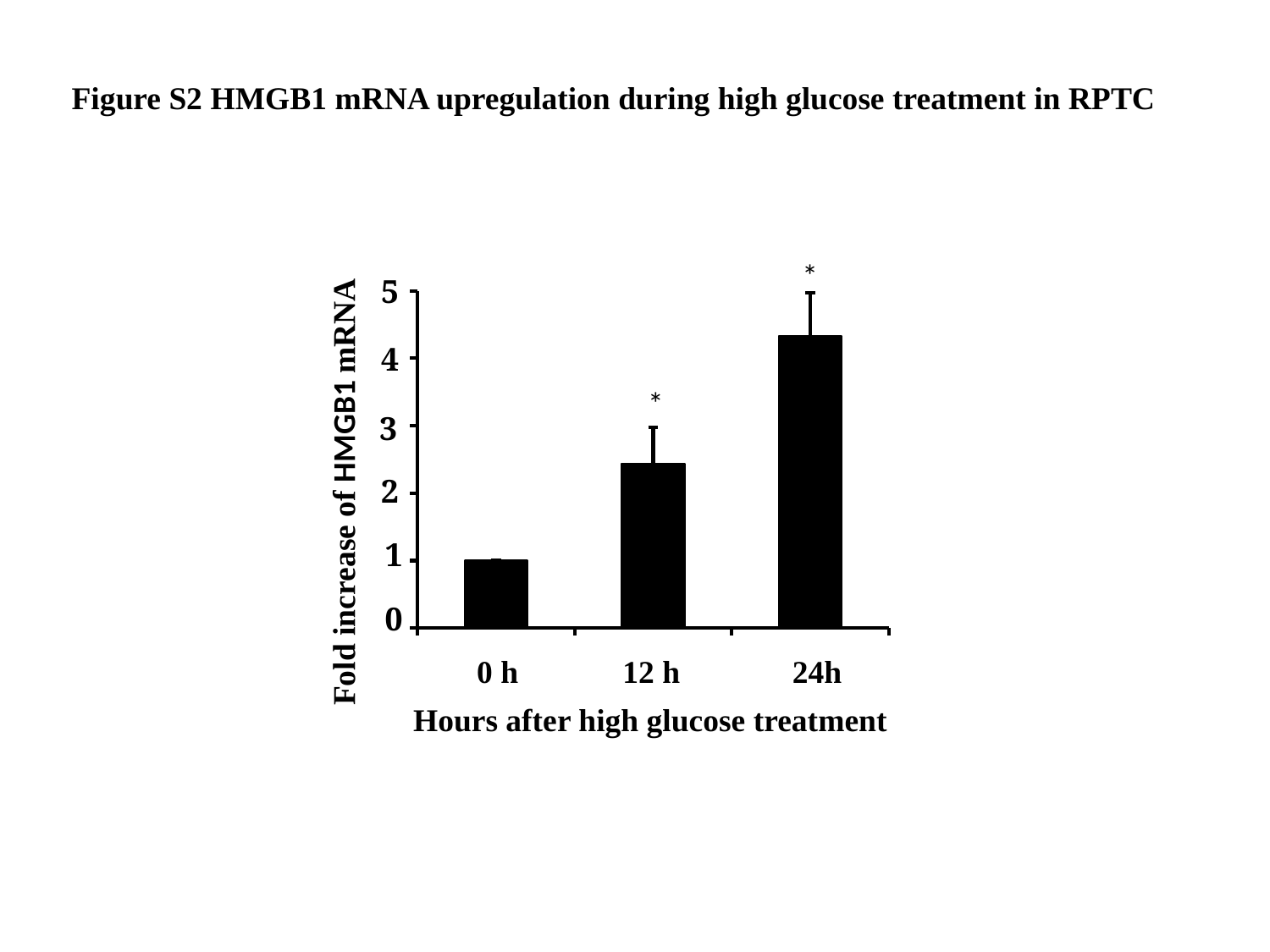
Is the value for 12 h greater or less than 2? greater Do the values rise or fall from 0 h to 24h? rise How many categories are plotted on the x axis? 3 Which time point has the highest fold increase of HMGB1 mRNA? 24h Is the value for 24h greater or less than 5? less What is the label of the x axis? Hours after high glucose treatment What is the fold increase of HMGB1 mRNA at 0 h? 1 Which time point has the lowest fold increase of HMGB1 mRNA? 0 h What kind of chart is shown on the slide? bar chart Is the value for 12 h greater or less than 3? less Which is larger, the value for 12 h or the value for 24h? 24h